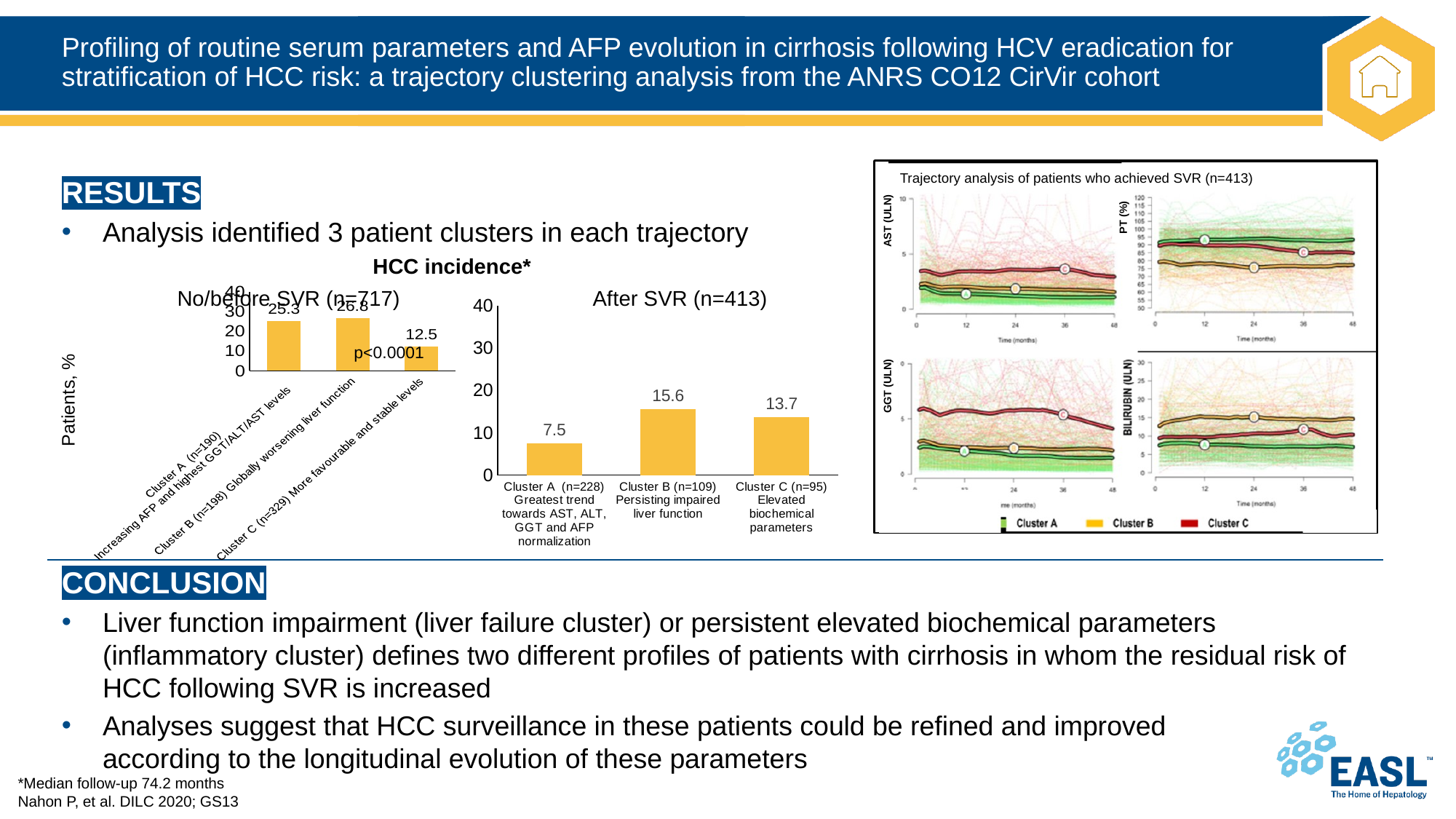
How many clusters are shown in the 'No/before SVR (n=717)' chart? 3 In the 'After SVR (n=413)' chart, is the value for Cluster B (n=109) or Cluster C (n=95) larger? Cluster B (n=109) In the 'After SVR (n=413)' chart, what is the HCC incidence for Cluster B (n=109)? 15.6 In the 'After SVR (n=413)' chart, what is the difference between the values for Cluster B (n=109) and Cluster C (n=95)? 1.9 In the 'After SVR (n=413)' chart, what is the value for Cluster A (n=228)? 7.5 In the 'After SVR (n=413)' chart, is the value for Cluster A (n=228) greater or less than 10? less In the 'No/before SVR (n=717)' chart, which cluster has the highest HCC incidence? Cluster B (n=198) In the 'After SVR (n=413)' chart, which cluster has the lowest HCC incidence? Cluster A (n=228) What type of chart is the 'After SVR (n=413)' chart? bar chart What is the p-value shown on the 'No/before SVR (n=717)' chart? p<0.0001 In the 'No/before SVR (n=717)' chart, what is the difference between the values for Cluster B (n=198) and Cluster C (n=329)? 14.3 In the 'No/before SVR (n=717)' chart, what is the value for Cluster C (n=329)? 12.5